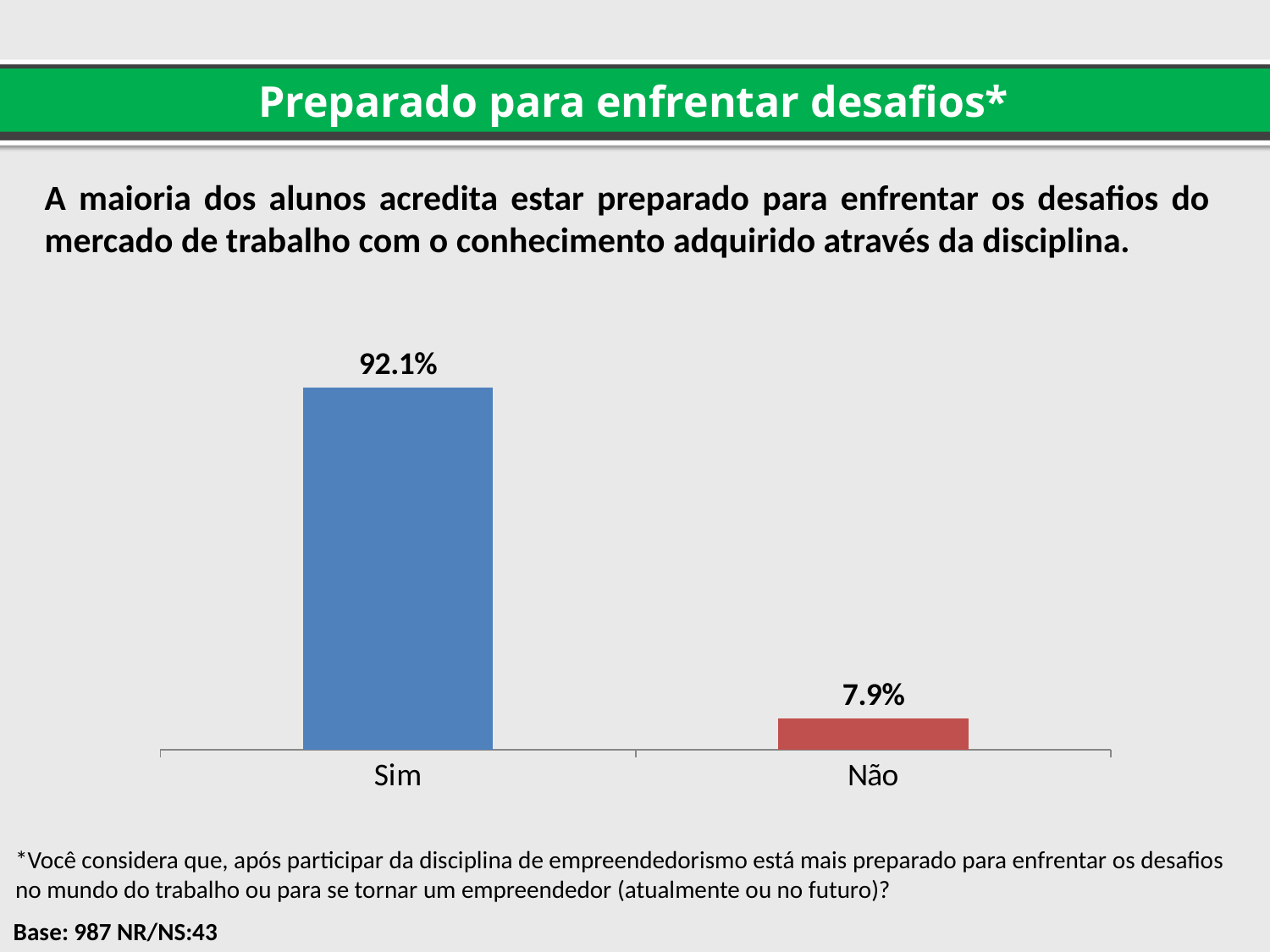
Which category has the lowest value? Não What is the value for Não? 7.9% What colour is the bar for Sim? Blue What is the difference between the values for Sim and Não? 84.2% What colour is the bar for Não? Red How many categories are shown in the chart? 2 Which is larger, the value for Sim or the value for Não? Sim What is the value for Sim? 92.1% What kind of chart is shown on the slide? Bar chart What is the total of the values for Sim and Não? 100% Which category has the highest value? Sim